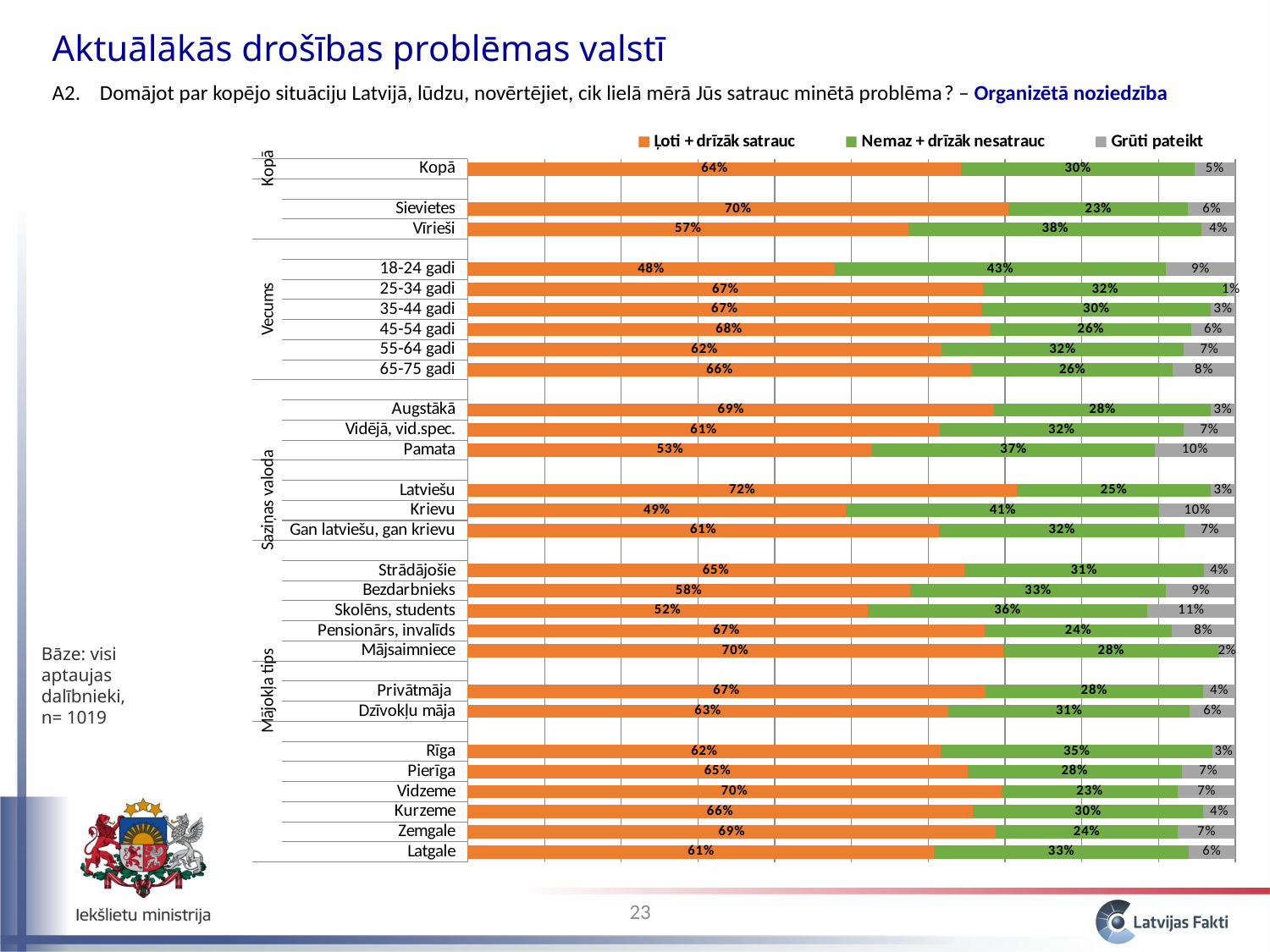
What is the "Nemaz + drīzāk nesatrauc" value for "Krievu"? 41% What percentage of respondents in the "Kopā" category answered "Ļoti + drīzāk satrauc"? 64% What is the "Grūti pateikt" value for "Skolēns, students"? 11% Which category has the highest "Ļoti + drīzāk satrauc" value? Latviešu Which has a larger "Ļoti + drīzāk satrauc" value, "Rīga" or "Vidzeme"? Vidzeme Which category has the highest "Nemaz + drīzāk nesatrauc" value? 18-24 gadi Which category has the lowest "Ļoti + drīzāk satrauc" value? 18-24 gadi Which series is shown in orange in the legend? Ļoti + drīzāk satrauc What is the total of the three values for "Pamata"? 100% What type of chart is shown on the slide? Stacked bar chart How many series does the legend list? 3 What is the difference between the "Ļoti + drīzāk satrauc" values for "Sievietes" and "Vīrieši"? 13%